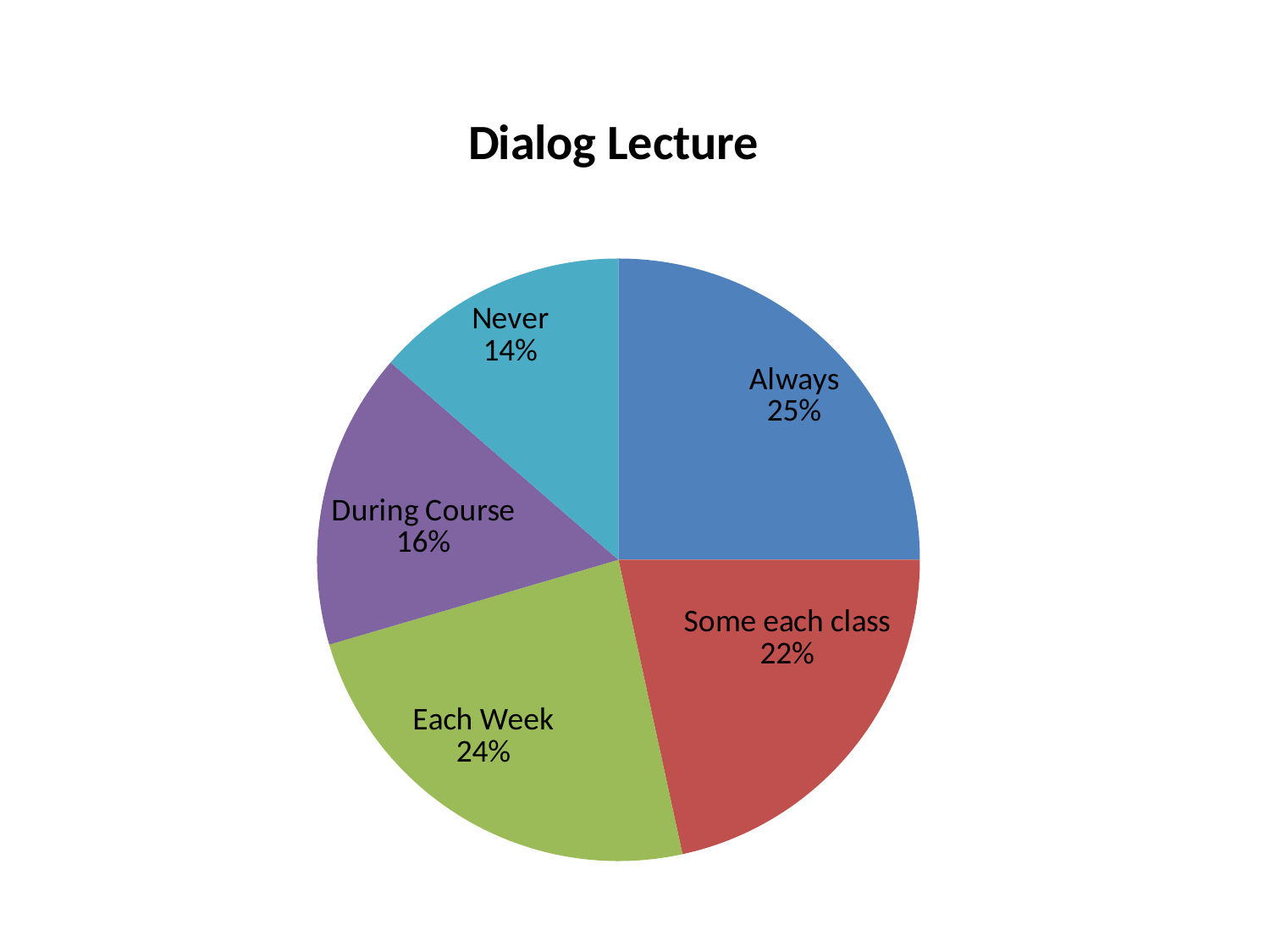
What percentage is shown for During Course? 16% What kind of chart is shown on the slide? Pie chart How many slices does the pie chart have? 5 What percentage is shown for Each Week? 24% What is the title of the chart? Dialog Lecture What is the difference in percentage points between Each Week and Some each class? 2 Which is larger, Some each class or During Course? Some each class What percentage is shown for Never? 14% Which category has the smallest slice of the pie? Never What share of the pie does the Always slice represent? 25% What is the difference in percentage points between Always and Never? 11 Which category has the largest slice of the pie? Always